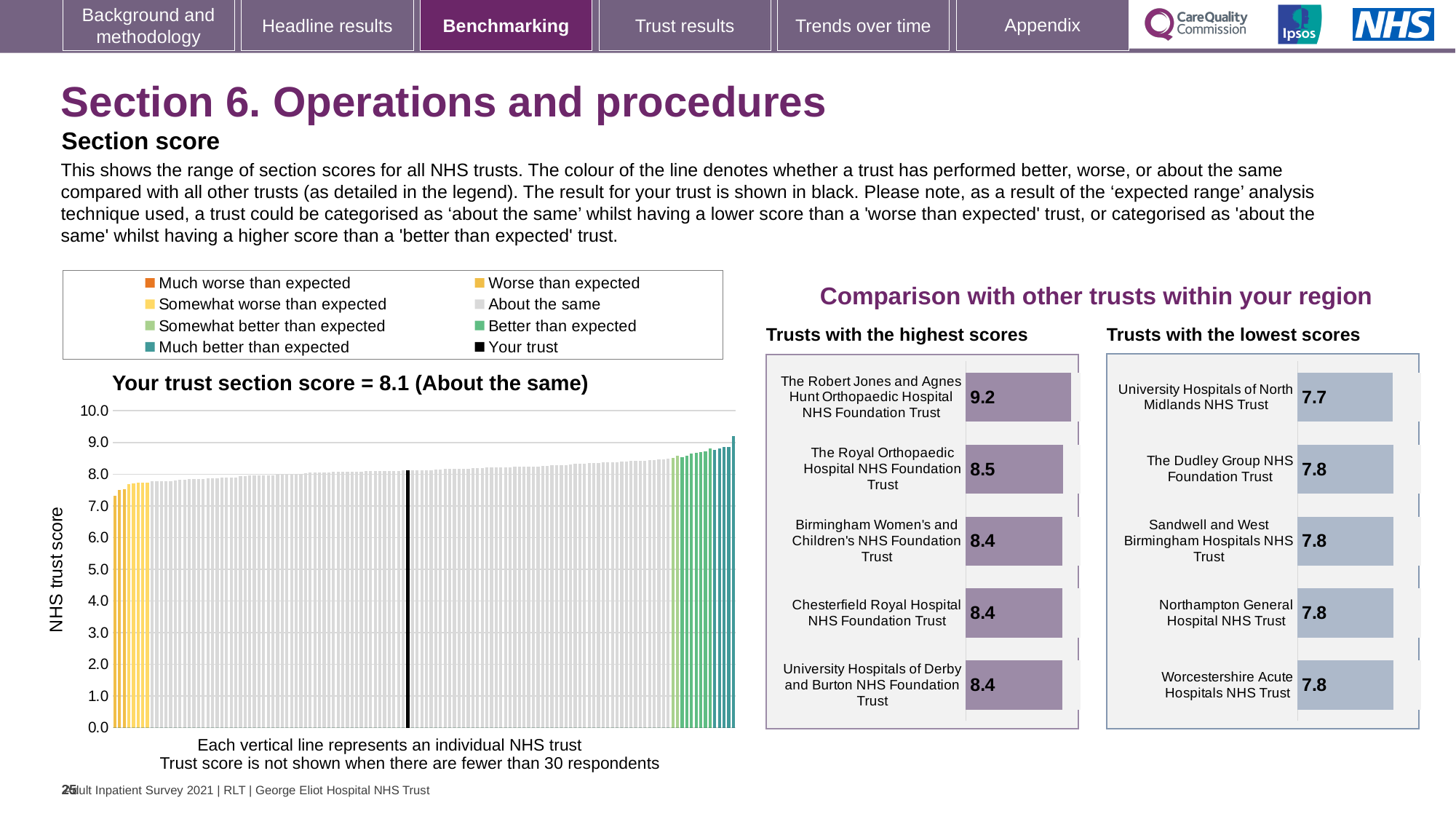
On the 'Trusts with the highest scores' chart, what is the score for The Royal Orthopaedic Hospital NHS Foundation Trust? 8.5 How many trusts are listed on the 'Trusts with the lowest scores' chart? 5 On the 'Trusts with the highest scores' chart, which trust has the highest score? The Robert Jones and Agnes Hunt Orthopaedic Hospital NHS Foundation Trust On the 'Trusts with the lowest scores' chart, which trust has the lowest score? University Hospitals of North Midlands NHS Trust According to the title of the left-hand chart, what is your trust's section score? 8.1 (About the same) On the 'Trusts with the highest scores' chart, what is the difference between the scores of The Robert Jones and Agnes Hunt Orthopaedic Hospital NHS Foundation Trust and The Royal Orthopaedic Hospital NHS Foundation Trust? 0.7 What kind of chart is the 'Your trust section score' chart on the left? Bar chart On the 'Trusts with the highest scores' chart, which has the larger score: The Royal Orthopaedic Hospital NHS Foundation Trust or Chesterfield Royal Hospital NHS Foundation Trust? The Royal Orthopaedic Hospital NHS Foundation Trust On the 'Trusts with the lowest scores' chart, what is the score for University Hospitals of North Midlands NHS Trust? 7.7 On the 'Trusts with the lowest scores' chart, what is the score for Worcestershire Acute Hospitals NHS Trust? 7.8 On the 'Trusts with the highest scores' chart, what is the score for The Robert Jones and Agnes Hunt Orthopaedic Hospital NHS Foundation Trust? 9.2 How many entries does the legend of the 'Your trust section score' chart list? 8